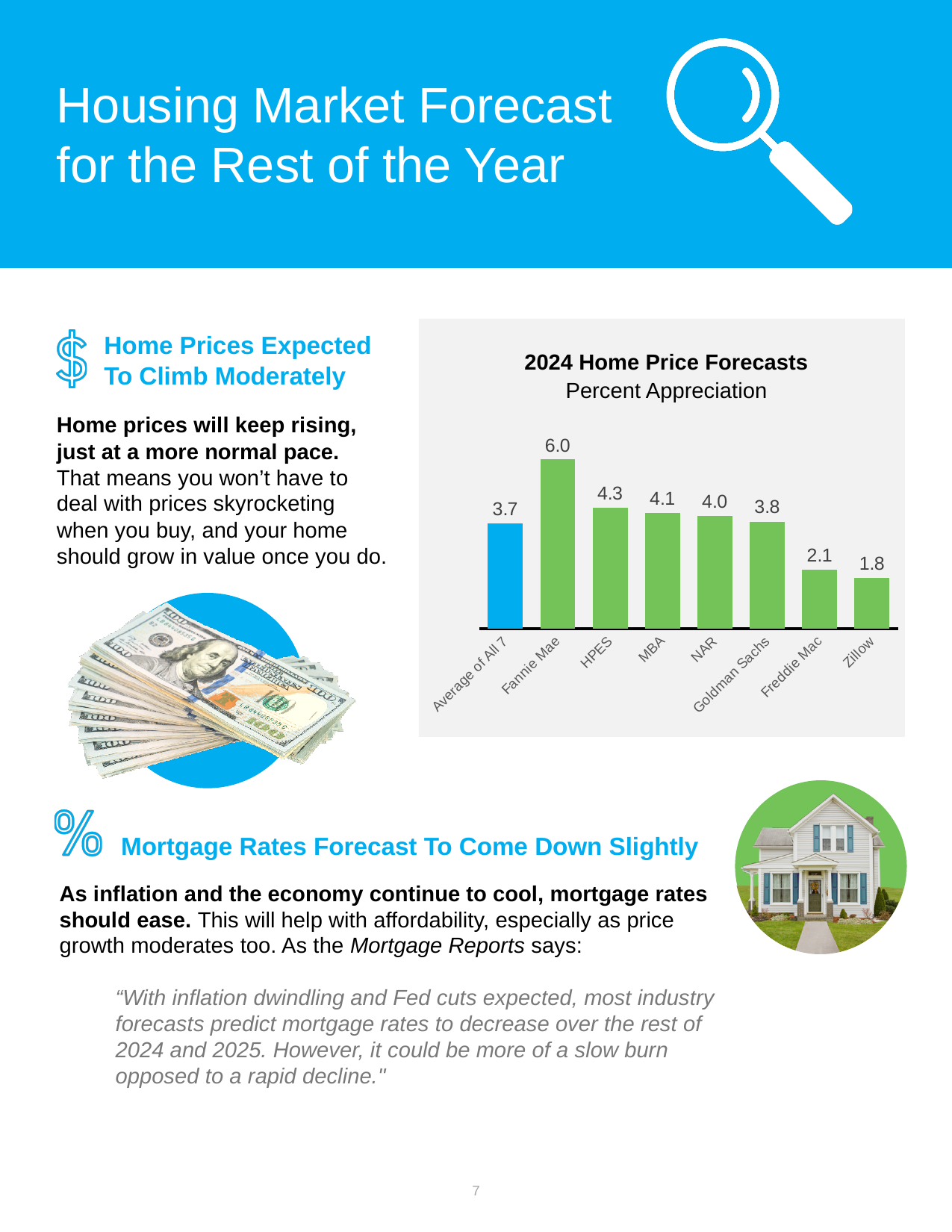
What is the forecast value for Fannie Mae? 6.0 What is the difference between the HPES forecast and the NAR forecast? 0.3 What is the value shown for Average of All 7? 3.7 What is the title of the chart? 2024 Home Price Forecasts Which is larger, the MBA forecast or the Freddie Mac forecast? MBA What is the forecast value for Goldman Sachs? 3.8 What kind of chart is shown on the slide? Bar chart How many bars are shown in the chart? 8 What is the difference between the Fannie Mae forecast and the Freddie Mac forecast? 3.9 Which forecaster has the highest percent appreciation forecast? Fannie Mae What is the forecast value for Zillow? 1.8 Which forecaster has the lowest percent appreciation forecast? Zillow